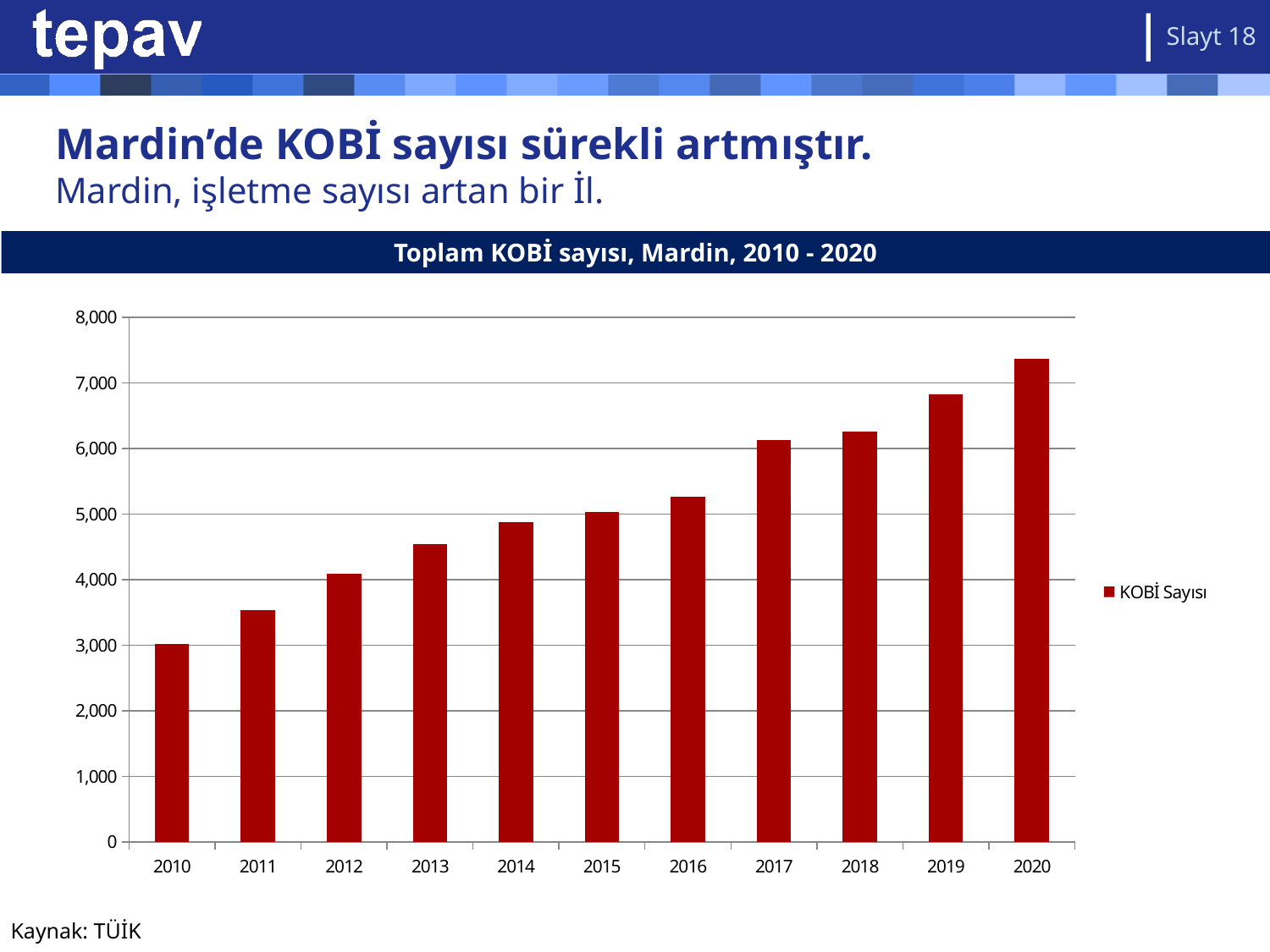
How many series does the legend list? 1 Which year has the lowest KOBİ Sayısı value? 2010 How many years are shown on the x axis of the chart? 11 What is the title of the chart? Toplam KOBİ sayısı, Mardin, 2010 - 2020 Is the value for 2019 greater or less than 7,000? less Is the value for 2010 greater or less than 4,000? less Which year has the highest KOBİ Sayısı value? 2020 Do the KOBİ Sayısı values rise or fall from 2010 to 2020? rise Is the value for 2016 greater or less than 5,000? greater Which is larger, the value for 2013 or the value for 2017? 2017 What kind of chart is shown on the slide? bar chart